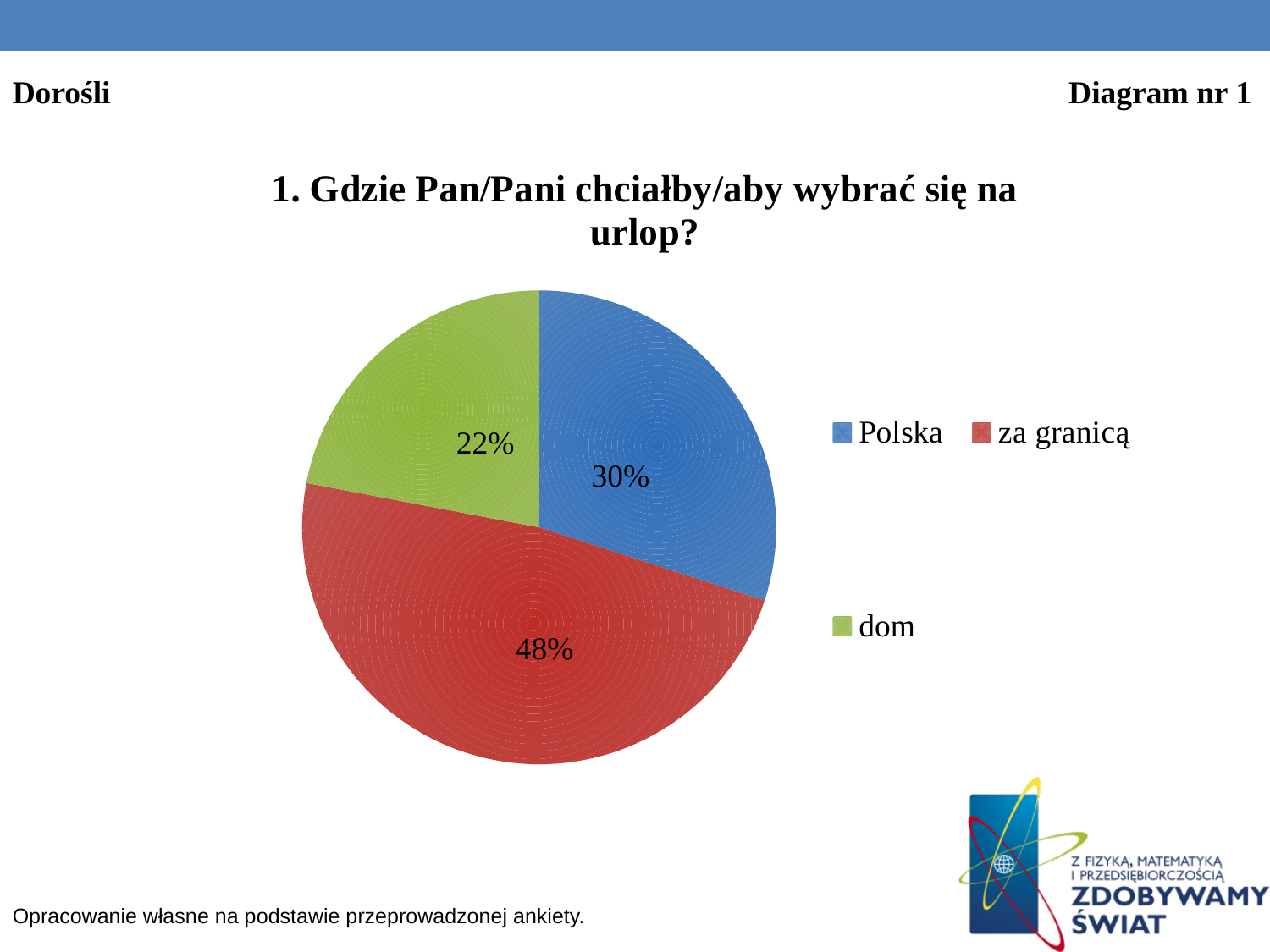
What is the difference in percentage points between "za granicą" and "Polska"? 18 What kind of chart is shown on the slide? pie chart Which category has the smallest slice of the pie? dom What share of the pie does "Polska" have? 30% What is the title of the chart? 1. Gdzie Pan/Pani chciałby/aby wybrać się na urlop? What share of the pie does "dom" have? 22% How many categories does the pie chart have? 3 What share of the pie does "za granicą" have? 48% Which category has the largest slice of the pie? za granicą Which is larger, the slice for "Polska" or the slice for "dom"? Polska What colour is the slice for "dom"? green What is the difference in percentage points between "Polska" and "dom"? 8